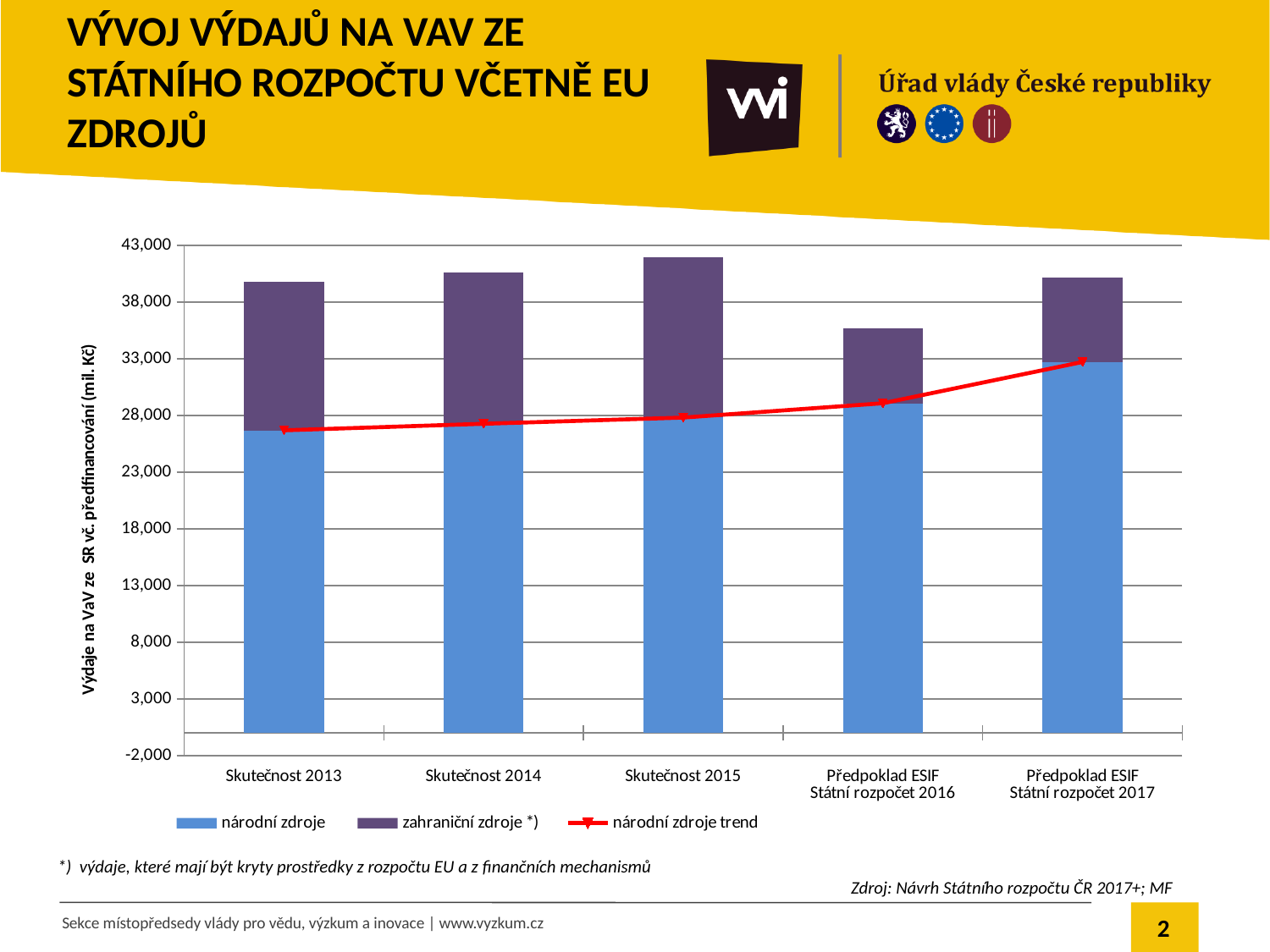
Does the národní zdroje trend line rise or fall from Skutečnost 2013 to Předpoklad ESIF Státní rozpočet 2017? rises Which legend entry is shown in blue? národní zdroje Is the total stacked bar for Předpoklad ESIF Státní rozpočet 2016 greater or less than 38,000? less Which category has the highest total stacked bar? Skutečnost 2015 What kind of chart is shown on the slide? stacked bar chart with a line How many series does the chart legend list? 3 Is the národní zdroje value for Předpoklad ESIF Státní rozpočet 2017 greater or less than 28,000? greater Which category has the lowest total stacked bar? Předpoklad ESIF Státní rozpočet 2016 Which is larger, the total stacked bar for Skutečnost 2014 or for Předpoklad ESIF Státní rozpočet 2016? Skutečnost 2014 Is the total stacked bar for Skutečnost 2015 greater or less than 38,000? greater How many categories are shown on the x axis of the chart? 5